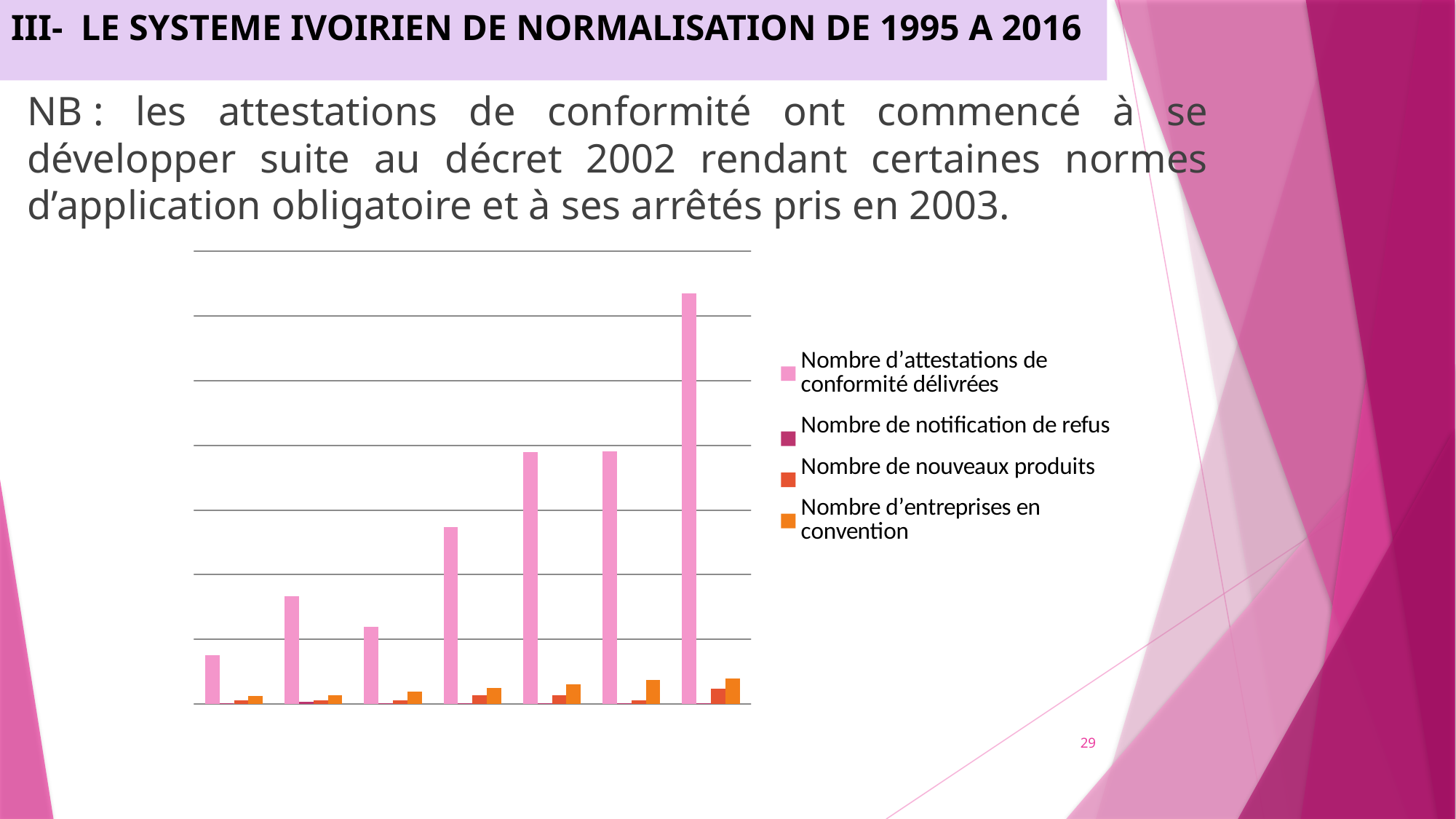
In which group of bars, counting from the left, does the 'Nombre d'attestations de conformité délivrées' series reach its highest value? the seventh (rightmost) group How many groups of bars are plotted along the x axis of the chart? 7 Is the 'Nombre d'attestations de conformité délivrées' bar taller in the second group or in the third group from the left? the second group Which series has the tallest bars in the chart? Nombre d'attestations de conformité délivrées Which series is listed last in the chart's legend? Nombre d'entreprises en convention Which series has the smallest bars in the chart, barely visible above the baseline? Nombre de notification de refus What kind of chart is shown on the slide? bar chart In which group of bars, counting from the left, is the 'Nombre d'attestations de conformité délivrées' bar the lowest? the first (leftmost) group Do the values of the 'Nombre d'attestations de conformité délivrées' series generally rise or fall from left to right across the chart? rise How many series does the chart's legend list? 4 Which series is shown in light pink in the chart's legend? Nombre d'attestations de conformité délivrées